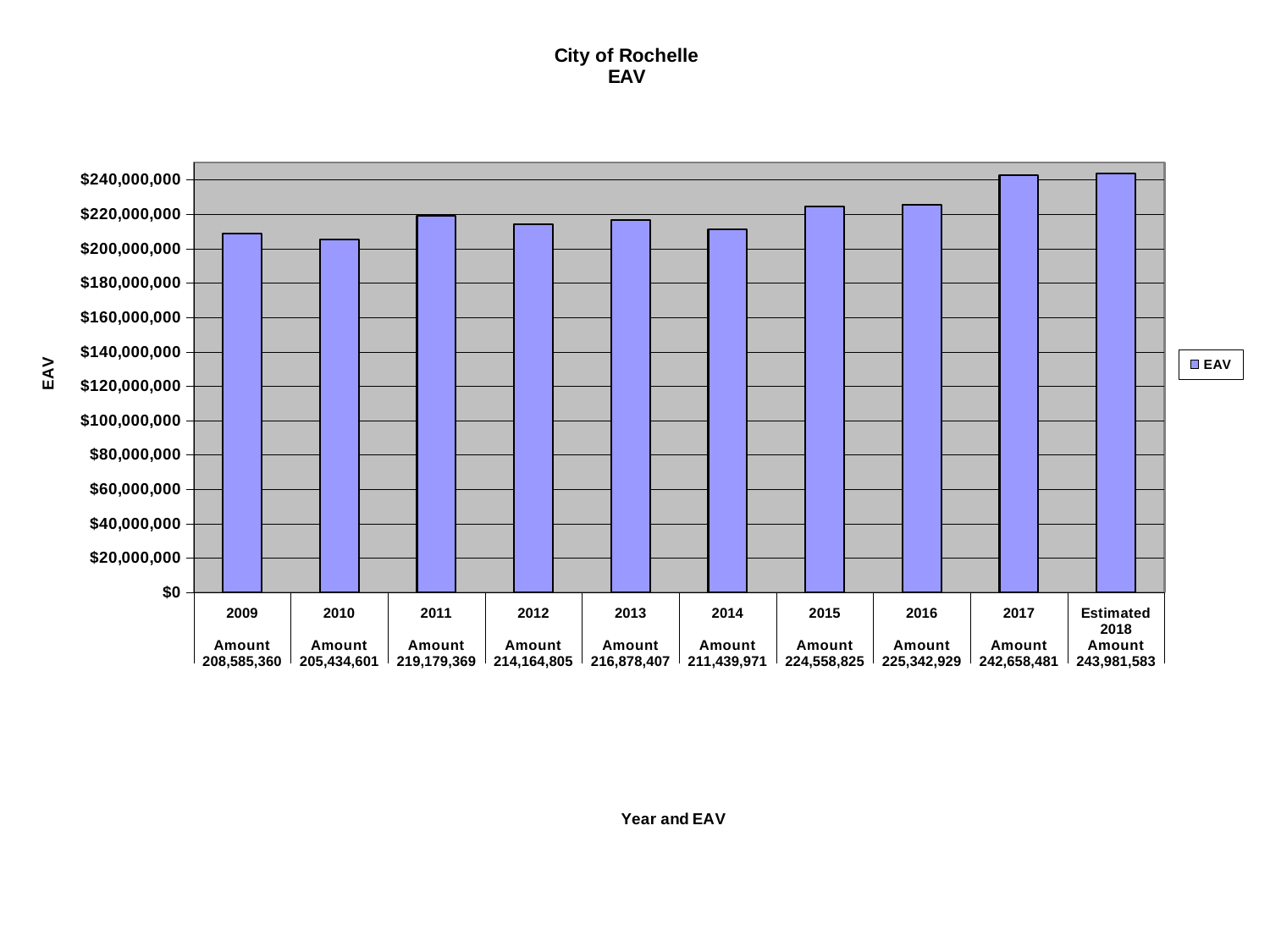
How many years (bars) are shown in the chart? 10 What is the EAV amount for 2014? 211,439,971 Which year has the lowest EAV? 2010 Which year has the highest EAV? Estimated 2018 Which year has a larger EAV, 2012 or 2013? 2013 What is the estimated EAV amount for 2018? 243,981,583 What kind of chart is shown? Bar chart What is the EAV amount for 2009? 208,585,360 What is the title of the chart? City of Rochelle EAV What is the difference between the EAV amounts for 2017 and 2016? 17,315,552 How many series does the legend list? 1 Is the EAV value for 2015 greater or less than $220,000,000? greater